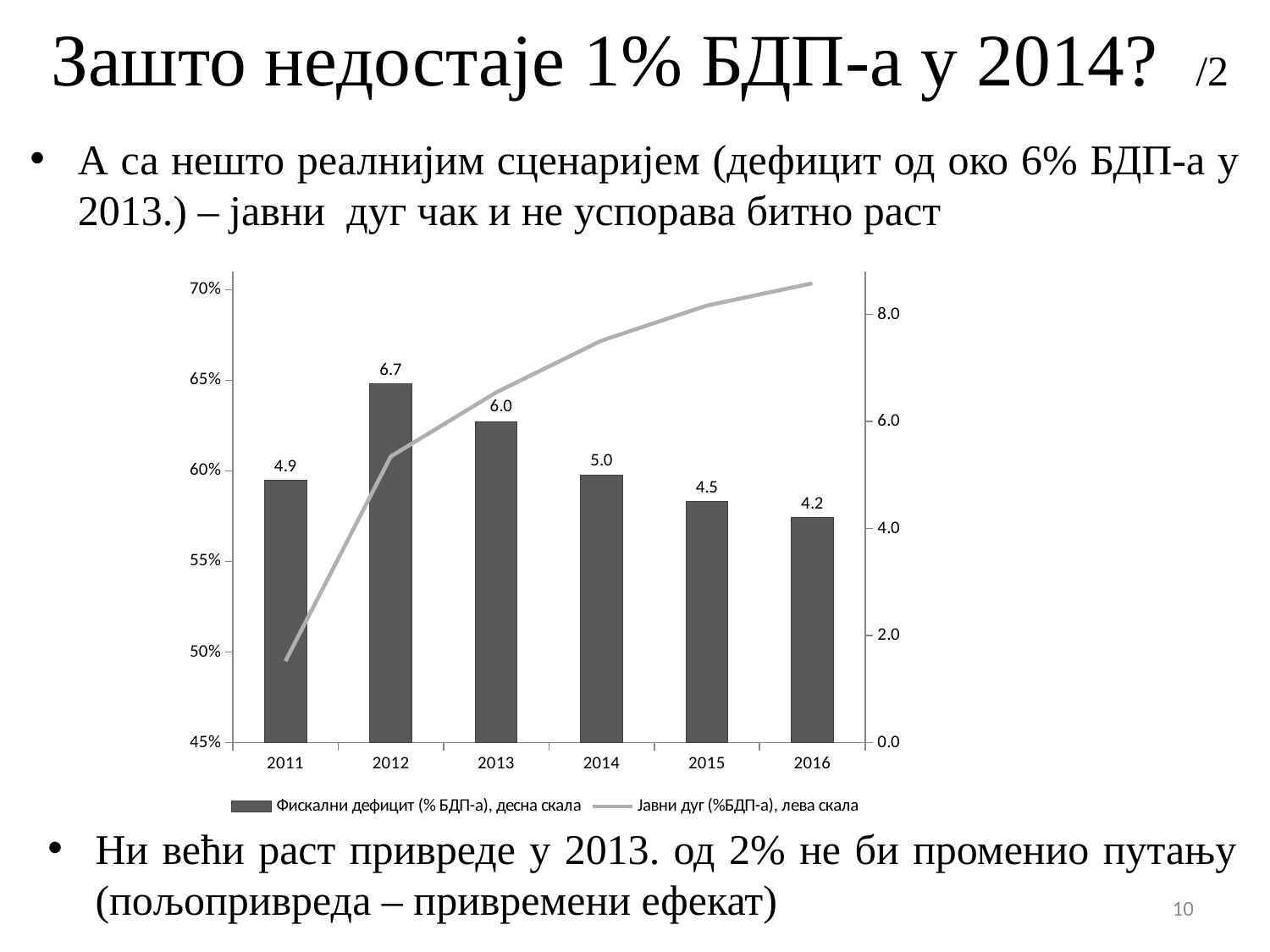
Which year has the highest fiscal deficit bar? 2012 How many series does the legend list? 2 What is the fiscal deficit value for 2014? 5.0 What is the fiscal deficit value for 2016? 4.2 How many years are shown on the x axis? 6 What is the difference between the fiscal deficit in 2012 and in 2013? 0.7 Is the public debt (Јавни дуг) value for 2011 greater or less than 55%? less What is the fiscal deficit (Фискални дефицит) value for 2012? 6.7 Which year has the lowest fiscal deficit bar? 2016 Which is larger, the fiscal deficit in 2011 or in 2015? 2011 Is the public debt value for 2016 greater or less than 65%? greater Does the public debt line rise or fall from 2011 to 2016? rises